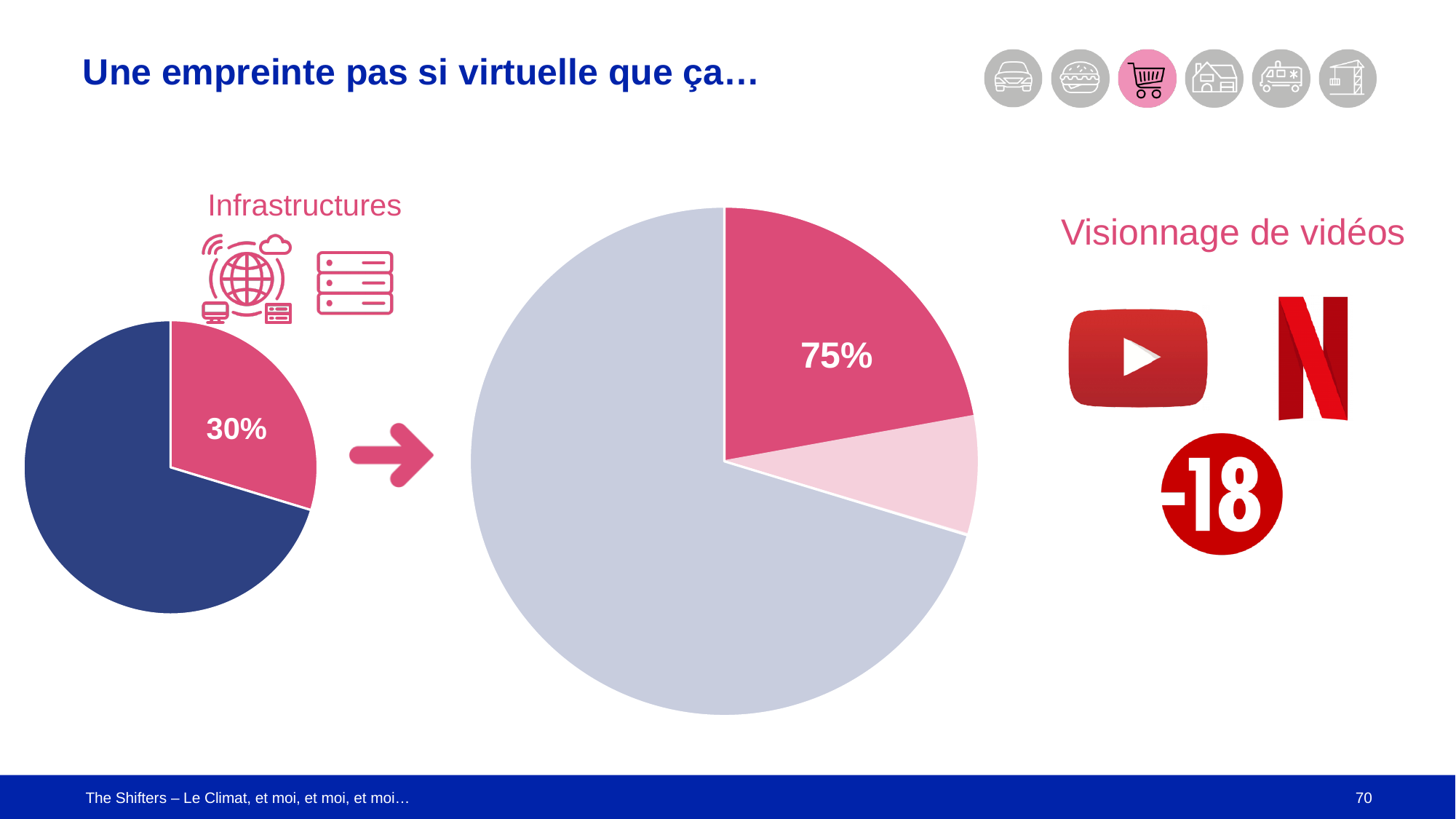
What percentage is printed on the pink slice of the large centre pie chart? 75% What label is written above the left pie chart? Infrastructures In the left pie chart, what share of the pie does the Infrastructures slice represent? 30% In the left pie chart, is the value of the pink slice greater or less than 50%? less In the left pie chart, what percentage is printed on the pink slice? 30% What kind of chart is the large chart in the centre of the slide? pie chart In the large centre pie chart, which slice is the smallest? the light pink slice In the left pie chart, which slice is larger, the dark blue slice or the pink slice? the dark blue slice How many slices does the large centre pie chart have? 3 In the large centre pie chart, which slice is the largest? the grey slice How many slices does the left pie chart have? 2 What kind of chart is the left chart on the slide? pie chart